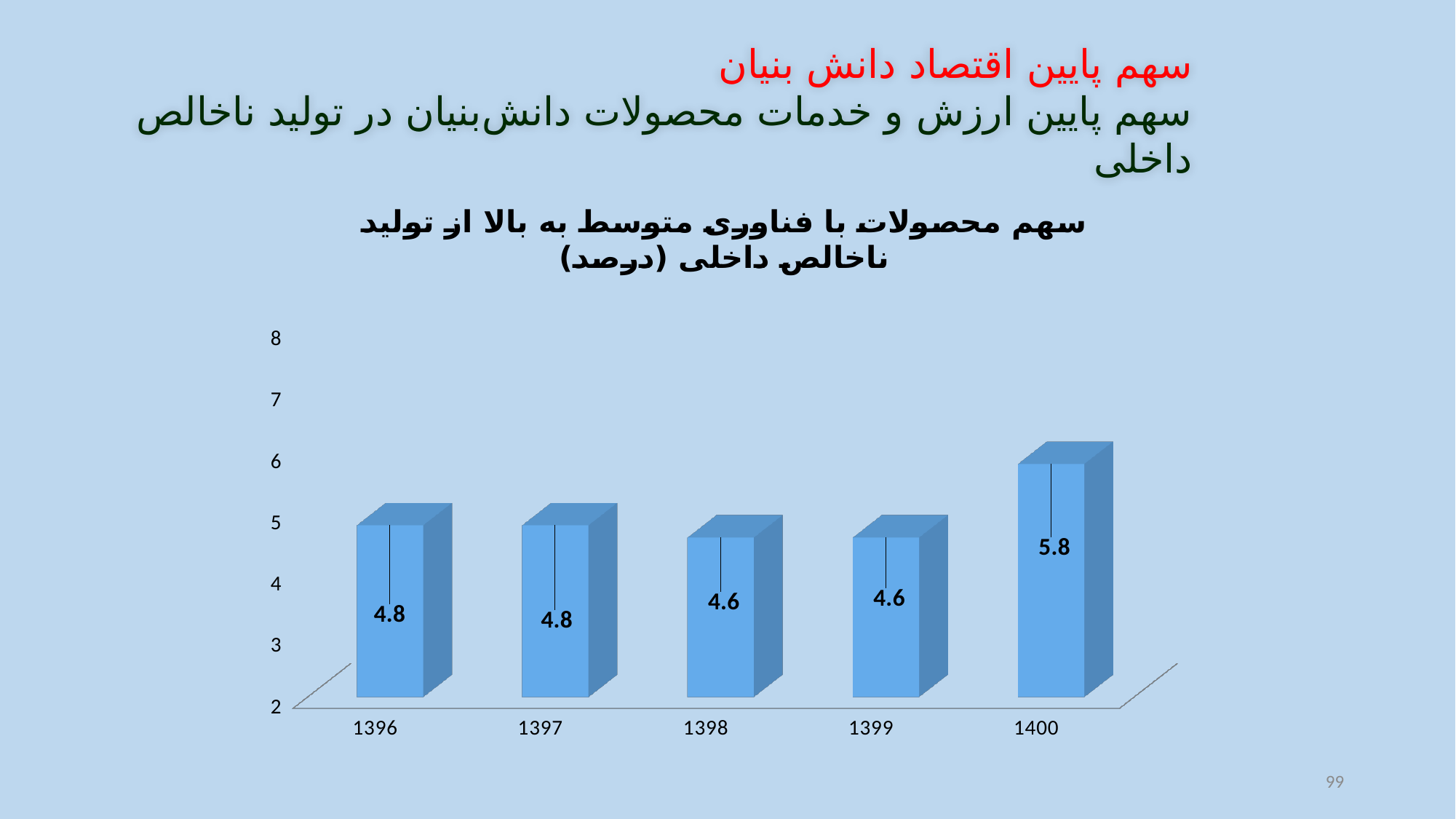
Which is larger, the value for 1397 or the value for 1400? 1400 What is the value for 1400? 5.8 What is the value for 1396? 4.8 What kind of chart is shown on the slide? bar chart How many years are shown on the x axis? 5 What is the difference between the values for 1396 and 1398? 0.2 Is the value for 1400 greater or less than 5? greater What is the difference between the values for 1400 and 1399? 1.2 What is the highest value shown on the vertical axis? 8 What is the value for 1398? 4.6 Which year has the highest value? 1400 Is the value for 1399 greater or less than 5? less